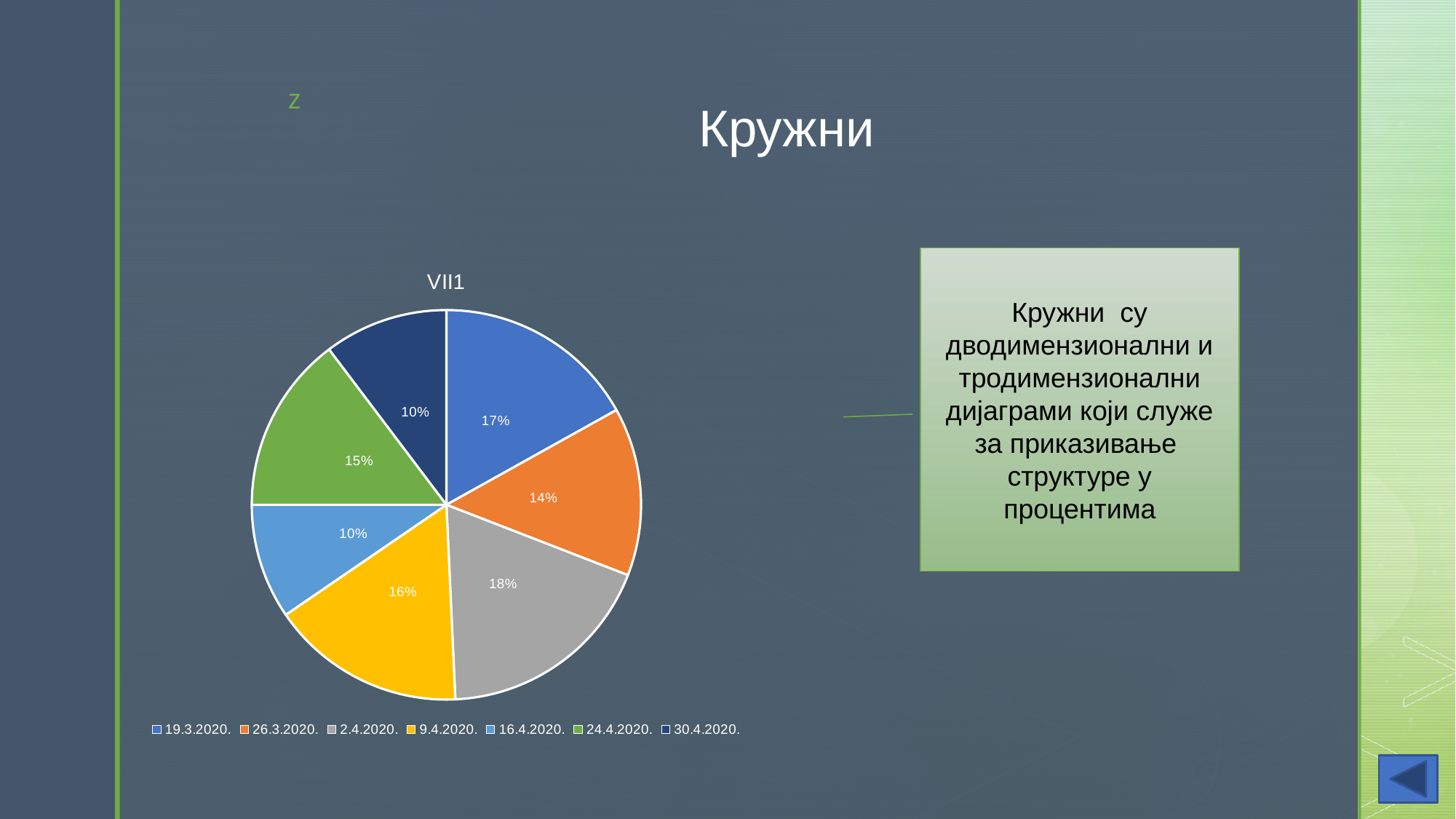
What share of the pie does 2.4.2020. have? 18% What is the title of the pie chart? VII1 What is the value for 9.4.2020. in the pie chart? 16% How many slices does the pie chart have? 7 What share of the pie does 19.3.2020. have? 17% What type of chart is shown on the slide? pie chart Which date has the largest slice of the pie? 2.4.2020. What is the difference between the shares for 2.4.2020. and 16.4.2020.? 8% Which is larger, the share for 19.3.2020. or the share for 26.3.2020.? 19.3.2020. Which legend entry is shown in yellow? 9.4.2020. What is the value for 26.3.2020. in the pie chart? 14% What is the value for 24.4.2020. in the pie chart? 15%